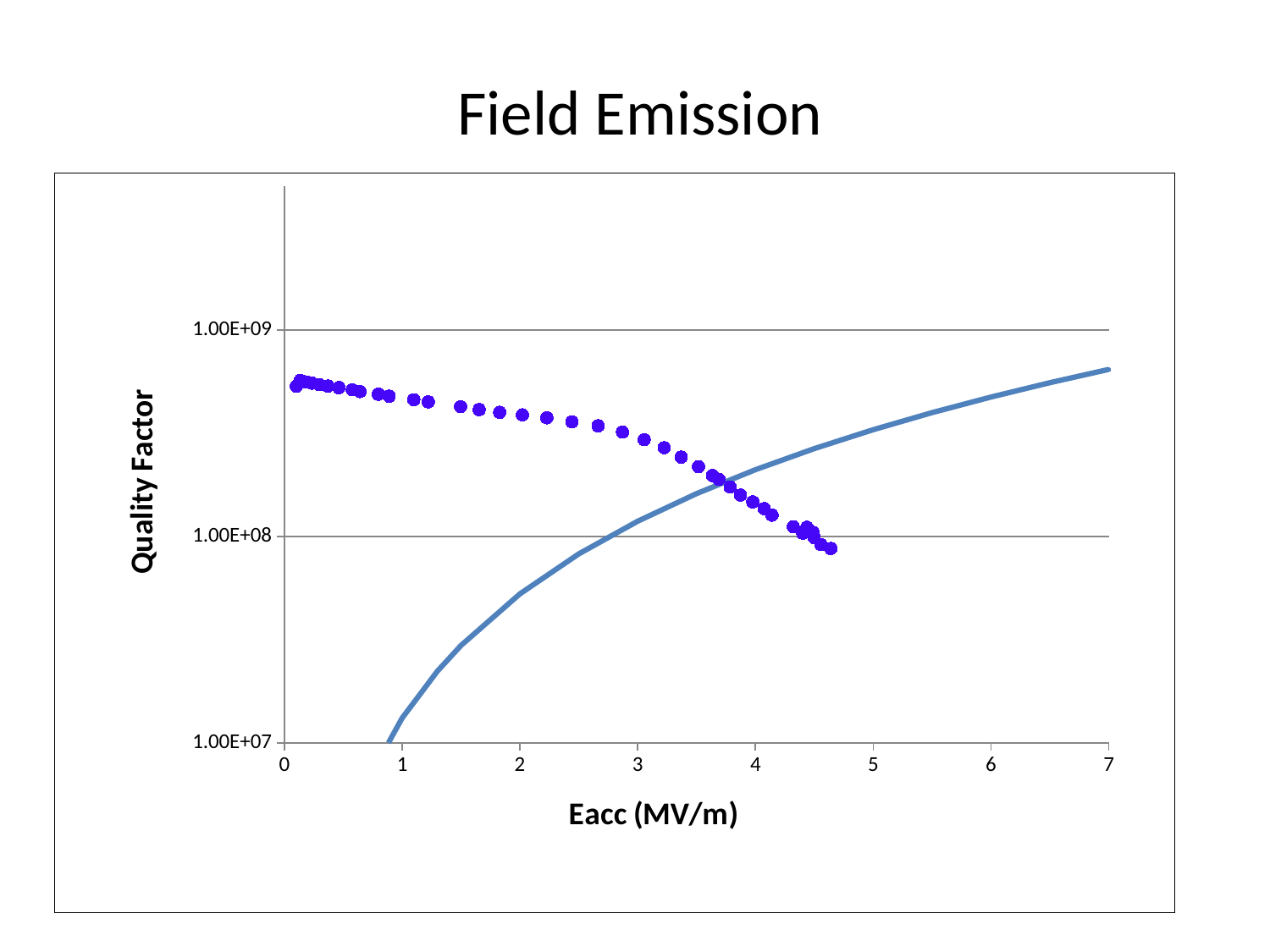
Is the Quality Factor of the purple dots at Eacc = 1 MV/m greater or less than 1.00E+08? greater Do the purple dots rise or fall as Eacc increases? fall Is the Quality Factor of the purple dots at Eacc = 2 MV/m greater or less than 1.00E+09? less What is the label of the x axis? Eacc (MV/m) Is the Quality Factor of the blue line at Eacc = 7 MV/m greater or less than 1.00E+09? less What is the title of the chart? Field Emission Does the blue line rise or fall as Eacc increases? rise At Eacc = 4.5 MV/m, which has the higher Quality Factor, the purple dots or the blue line? the blue line At Eacc = 1 MV/m, which has the higher Quality Factor, the purple dots or the blue line? the purple dots What type of chart is shown on the slide? scatter chart